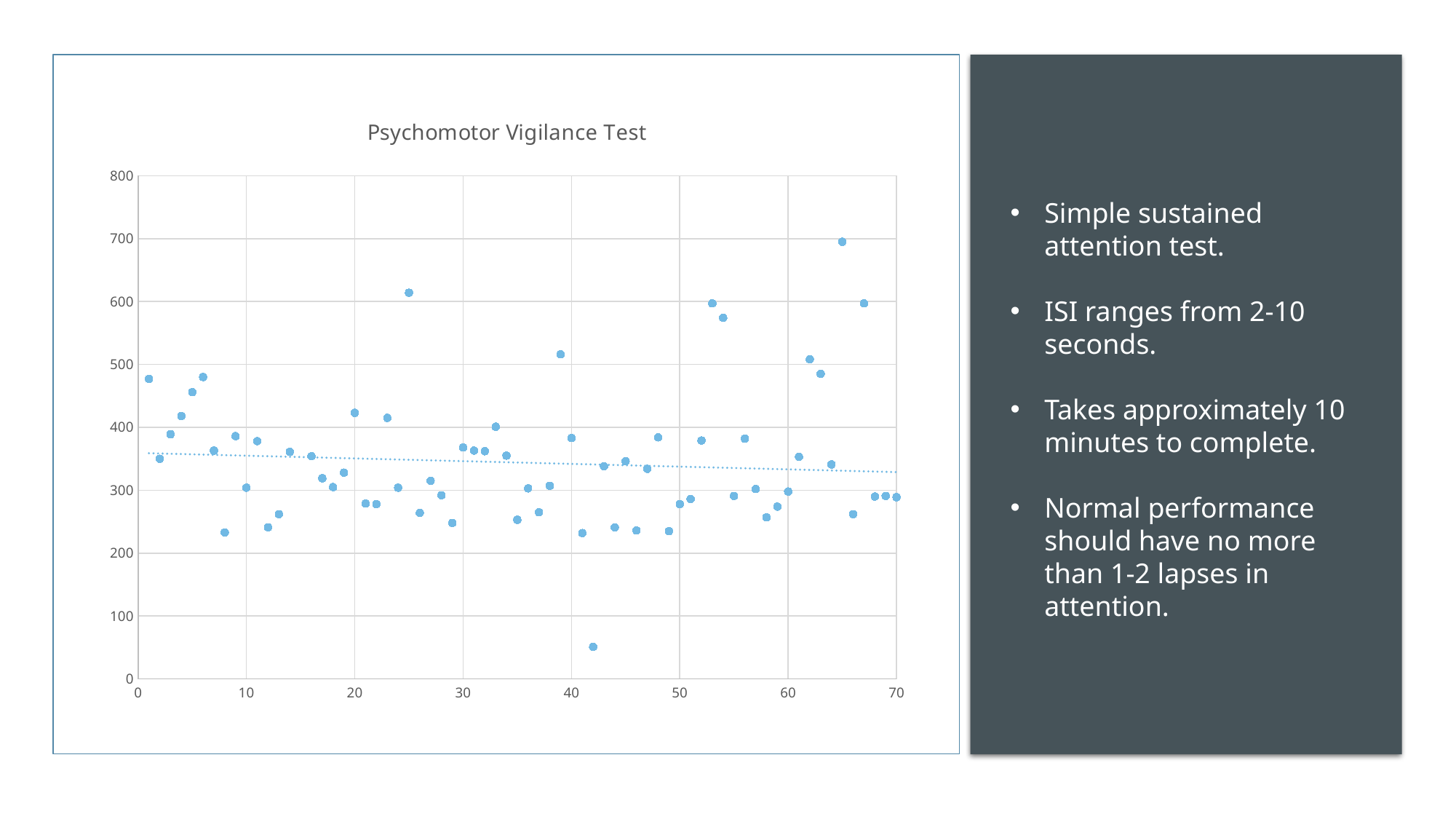
What is the maximum value shown on the y axis? 800 Is the value at x = 42 greater or less than 100? less Is the value at x = 65 greater or less than 600? greater At which x value does the lowest point on the chart occur? 42 Which point is higher: the one at x = 65 or the one at x = 54? x = 65 Is the value at x = 25 greater or less than 600? greater What kind of chart is shown on the slide? Scatter chart What is the title of the chart? Psychomotor Vigilance Test Does the dotted trendline rise or fall as x increases? Falls At which x value does the highest point on the chart occur? 65